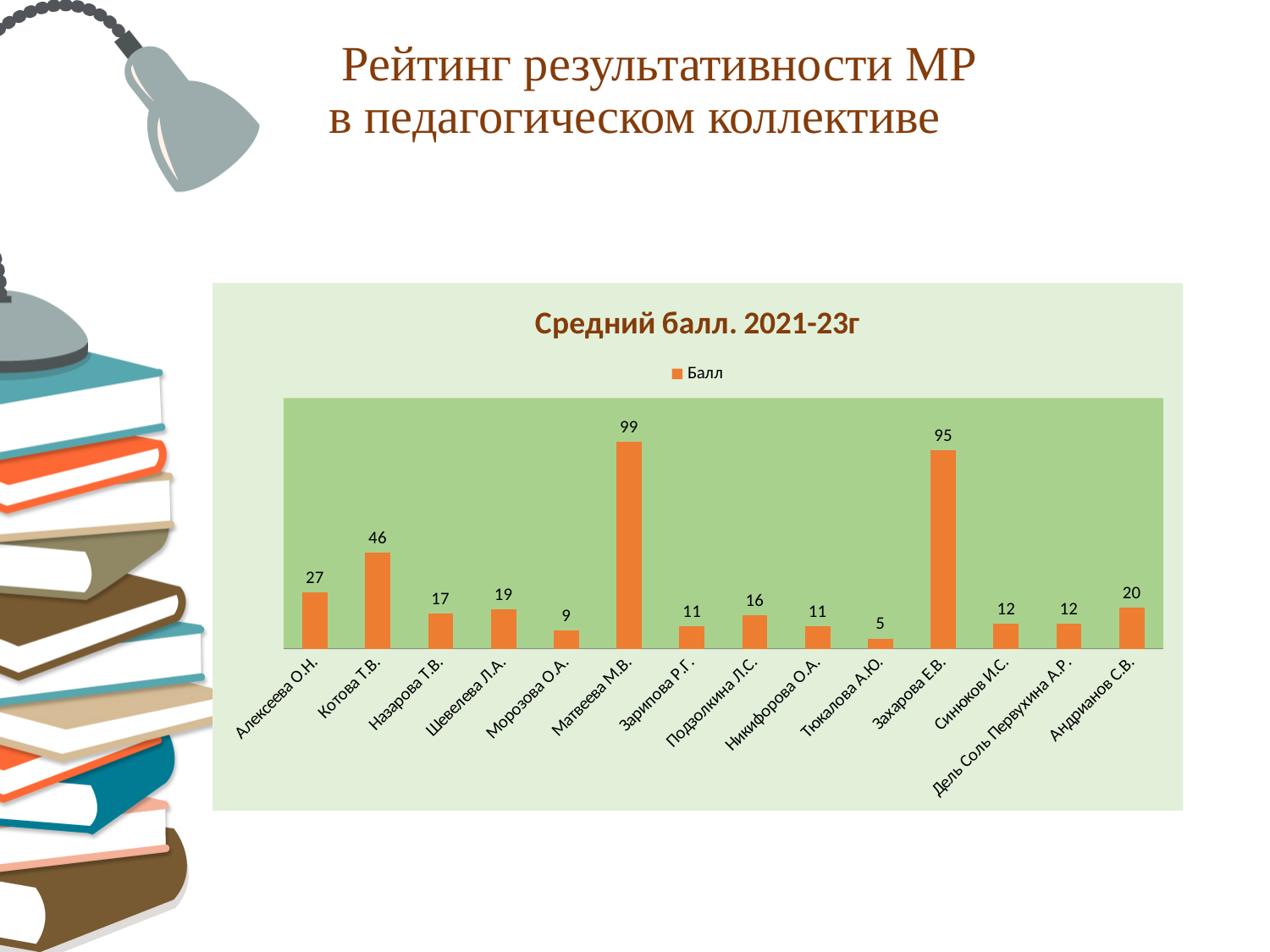
Which is larger, the value for Шевелева Л.А. or the value for Назарова Т.В.? Шевелева Л.А. What kind of chart is shown? bar chart What is the value for Андрианов С.В.? 20 What is the title of the chart? Средний балл. 2021-23г What is the value for Морозова О.А.? 9 What is the difference between the values for Матвеева М.В. and Захарова Е.В.? 4 How many series does the legend list? 1 What is the difference between the values for Котова Т.В. and Алексеева О.Н.? 19 How many categories are shown on the x axis? 14 Which category has the highest value? Матвеева М.В. What is the value for Котова Т.В.? 46 Which category has the lowest value? Тюкалова А.Ю.